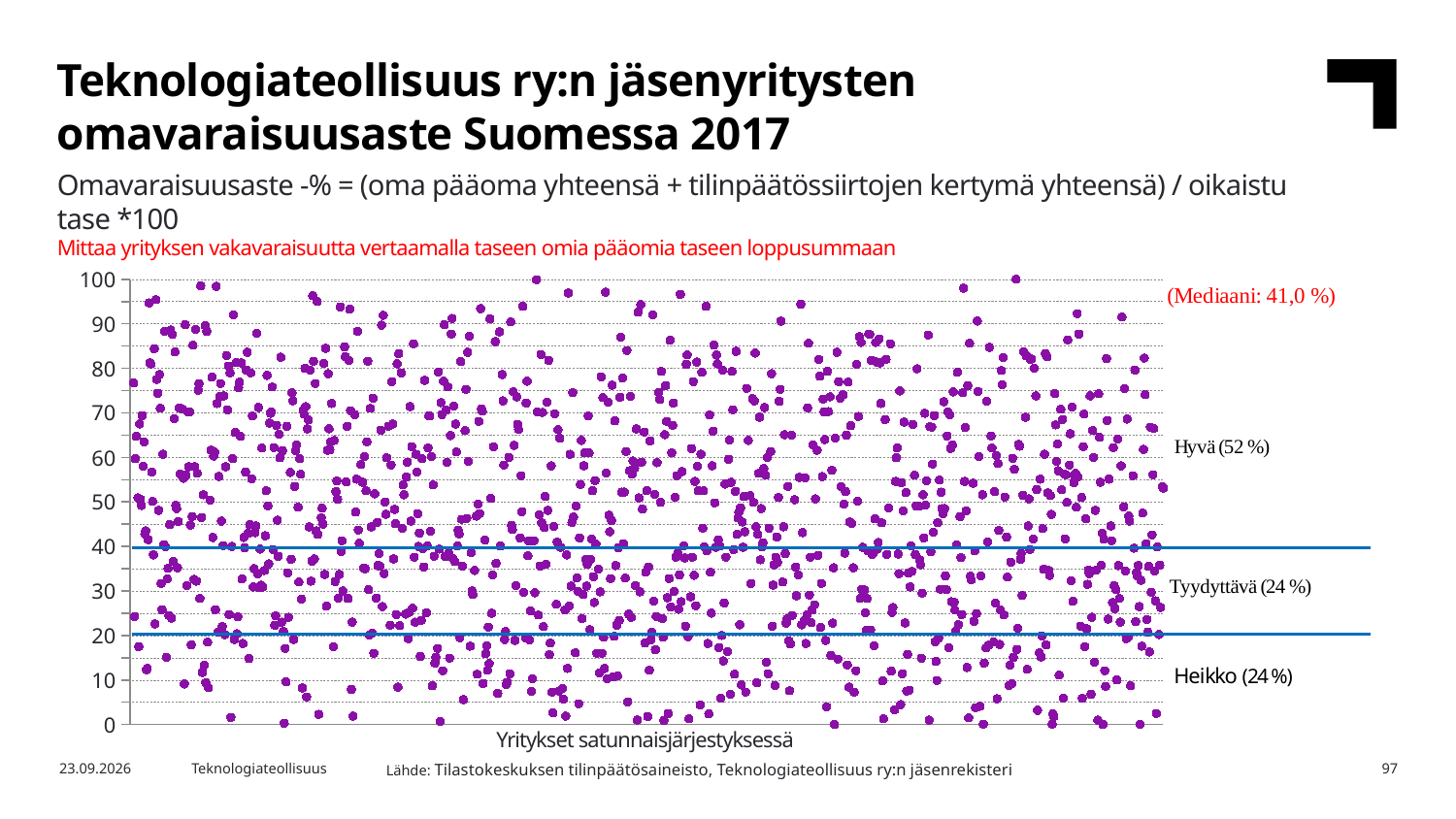
What share of companies falls into the 'Tyydyttävä' category according to the chart annotation? 24 % What share of companies falls into the 'Heikko' category according to the chart annotation? 24 % What is the maximum value shown on the y axis of the chart? 100 Is the share of companies in the 'Hyvä' category larger or smaller than the share in the 'Tyydyttävä' category? Larger At which y-axis values are the two horizontal blue threshold lines drawn? 40 and 20 What is the label of the x axis of the chart? Yritykset satunnaisjärjestyksessä Which category has the largest share of companies: Hyvä, Tyydyttävä or Heikko? Hyvä What is the median equity ratio (Mediaani) shown on the chart? 41,0 % What is the difference in percentage points between the share of companies in the 'Hyvä' category and the 'Heikko' category? 28 Is the median value of 41,0 % greater or less than 40 on the y axis? greater What share of companies falls into the 'Hyvä' category according to the chart annotation? 52 % What kind of chart is shown on the slide? Scatter chart